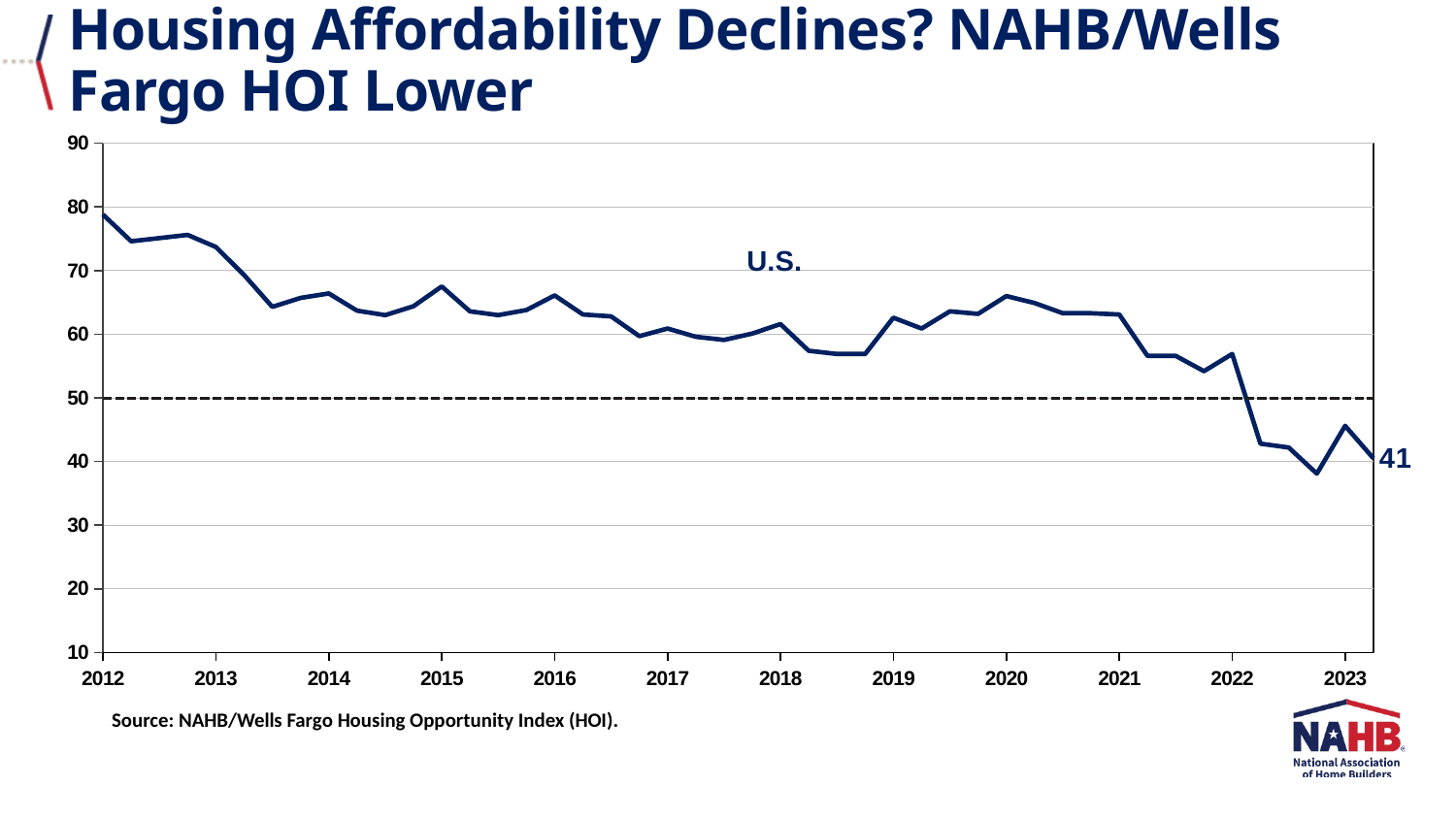
Is the final value in 2023 greater or less than 50? less Is the value at the start of 2020 greater or less than 60? greater Overall, does the Housing Opportunity Index rise or fall from 2012 to 2023? fall Is the value at the start of 2018 greater or less than 50? greater What kind of chart is shown on the slide? line chart At what level is the horizontal dashed reference line drawn? 50 What is the value printed at the end of the line in 2023? 41 What label identifies the plotted series on the chart? U.S. Which is larger, the value at the start of 2012 or the value at the end of 2023? 2012 In which year does the line reach its highest point? 2012 In which year does the line reach its lowest point? 2022